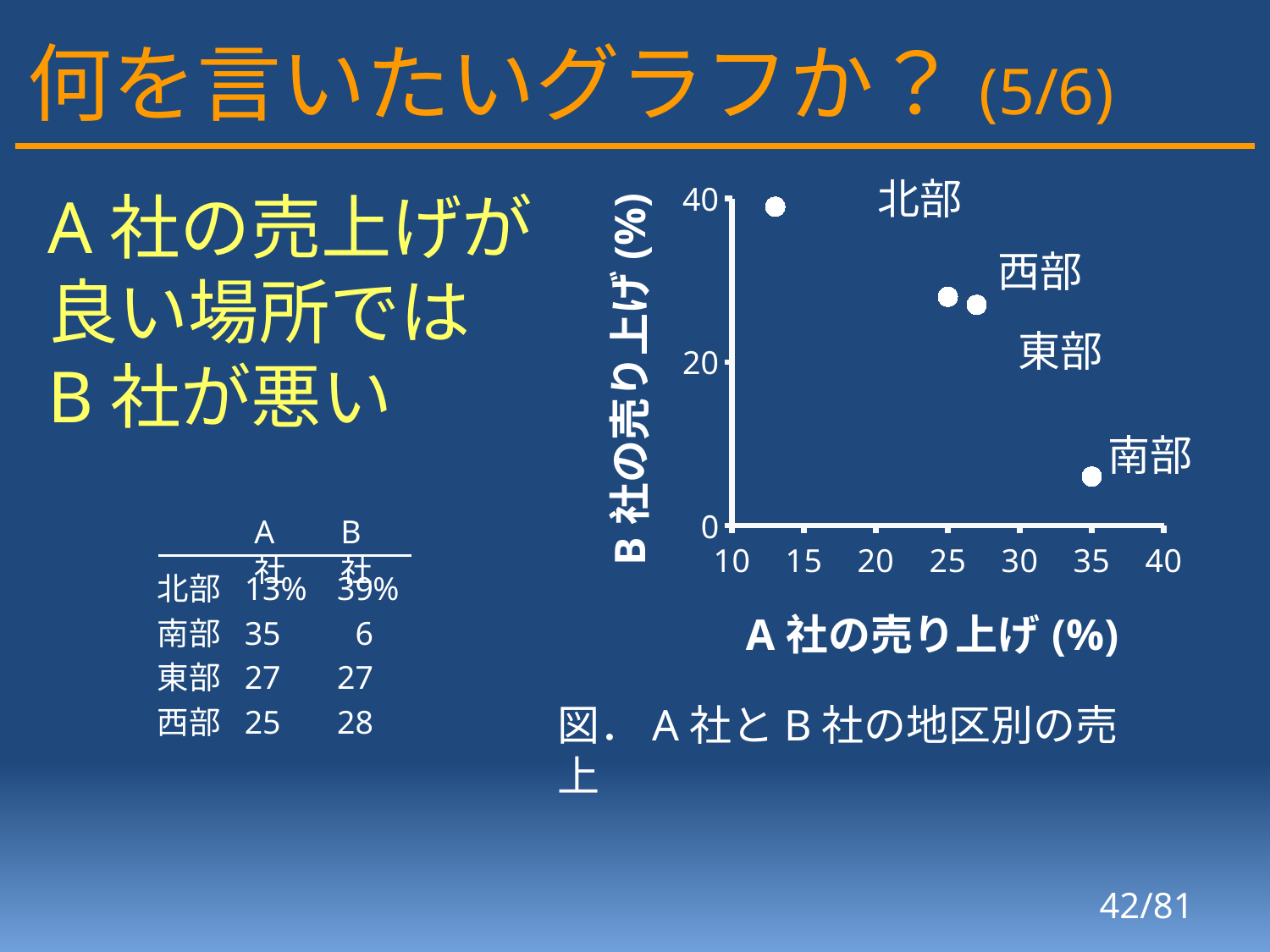
Which region has the lowest A社 sales (x axis) in the chart? 北部 Which region has the lowest B社 sales (y axis) in the chart? 南部 Which region has the highest B社 sales (y axis) in the chart? 北部 Is the B社 sales value for 南部 greater or less than 20? less As A社 sales increase along the x axis, do B社 sales rise or fall? fall What kind of chart is shown on the slide? scatter chart What is the label of the x axis of the chart? A 社の売り上げ (%) Which region has higher B社 sales, 北部 or 南部? 北部 Which region has the highest A社 sales (x axis) in the chart? 南部 Is the B社 sales value for 北部 greater or less than 20? greater Is the A社 sales value for 南部 greater or less than 30? greater How many data points are plotted in the chart? 4